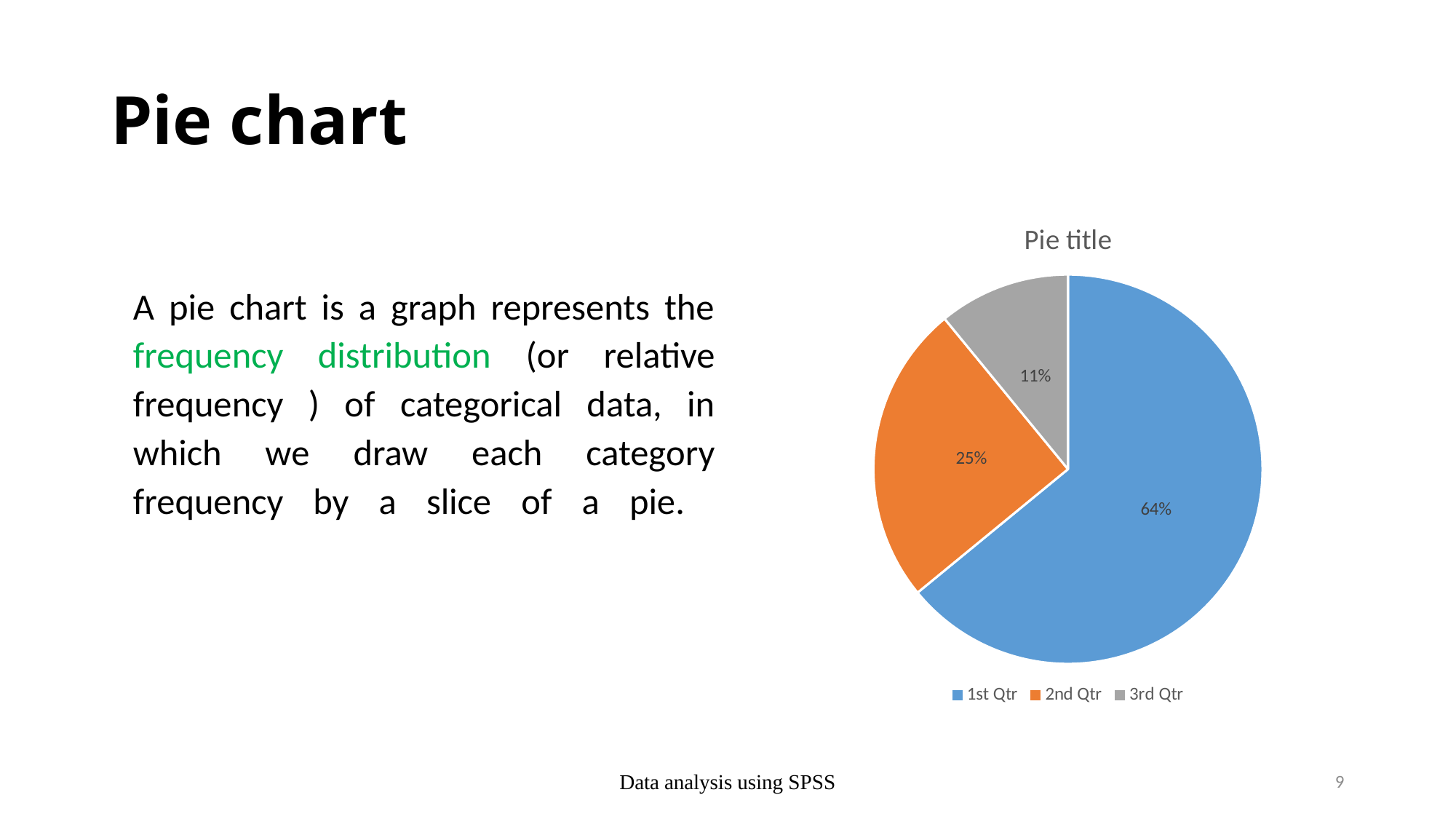
Which slice is larger, 2nd Qtr or 3rd Qtr? 2nd Qtr What type of chart is shown on the slide? pie chart How many entries does the legend list? 3 Which category has the largest slice of the pie? 1st Qtr How many slices does the pie chart have? 3 What share of the pie does 1st Qtr have? 64% Which category has the smallest slice of the pie? 3rd Qtr What colour is the 2nd Qtr slice? orange What is the difference in percentage points between the 1st Qtr and 2nd Qtr slices? 39 What share of the pie does 2nd Qtr have? 25% What share of the pie does 3rd Qtr have? 11% What is the title of the chart? Pie title